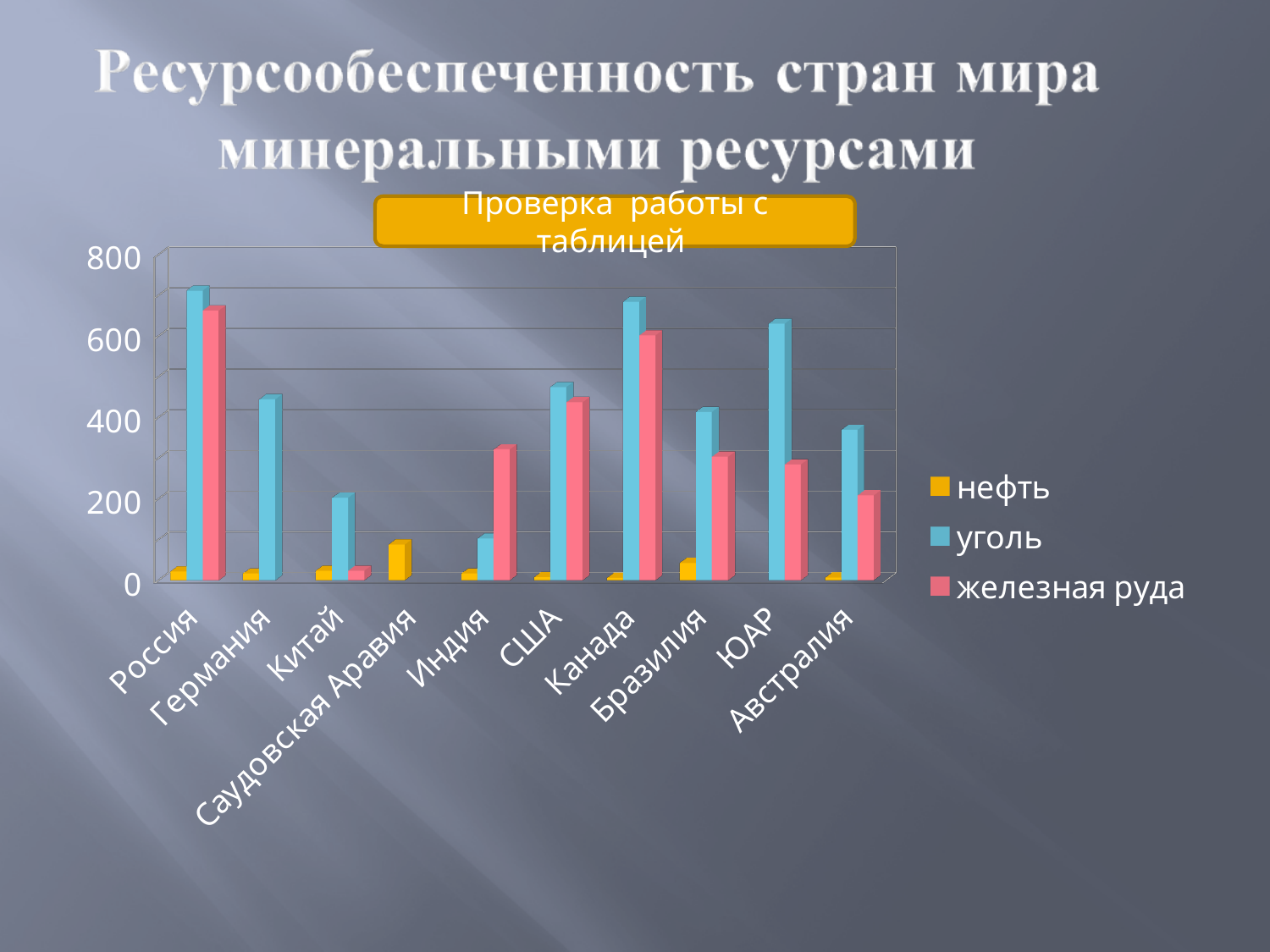
Is the value for железная руда in Индия greater or less than 200? greater Which country has the highest value for железная руда? Россия How many countries are shown on the x axis? 10 Is the value for уголь in ЮАР greater or less than 600? greater Is the value for уголь in Россия greater or less than 600? greater Which series is shown in pink in the legend? железная руда Which is larger, the уголь value for Германия or for Китай? Германия How many series does the legend list? 3 Which is larger, the железная руда value for Канада or for Бразилия? Канада Which country has the highest value for нефть? Саудовская Аравия What kind of chart is shown on the slide? bar chart